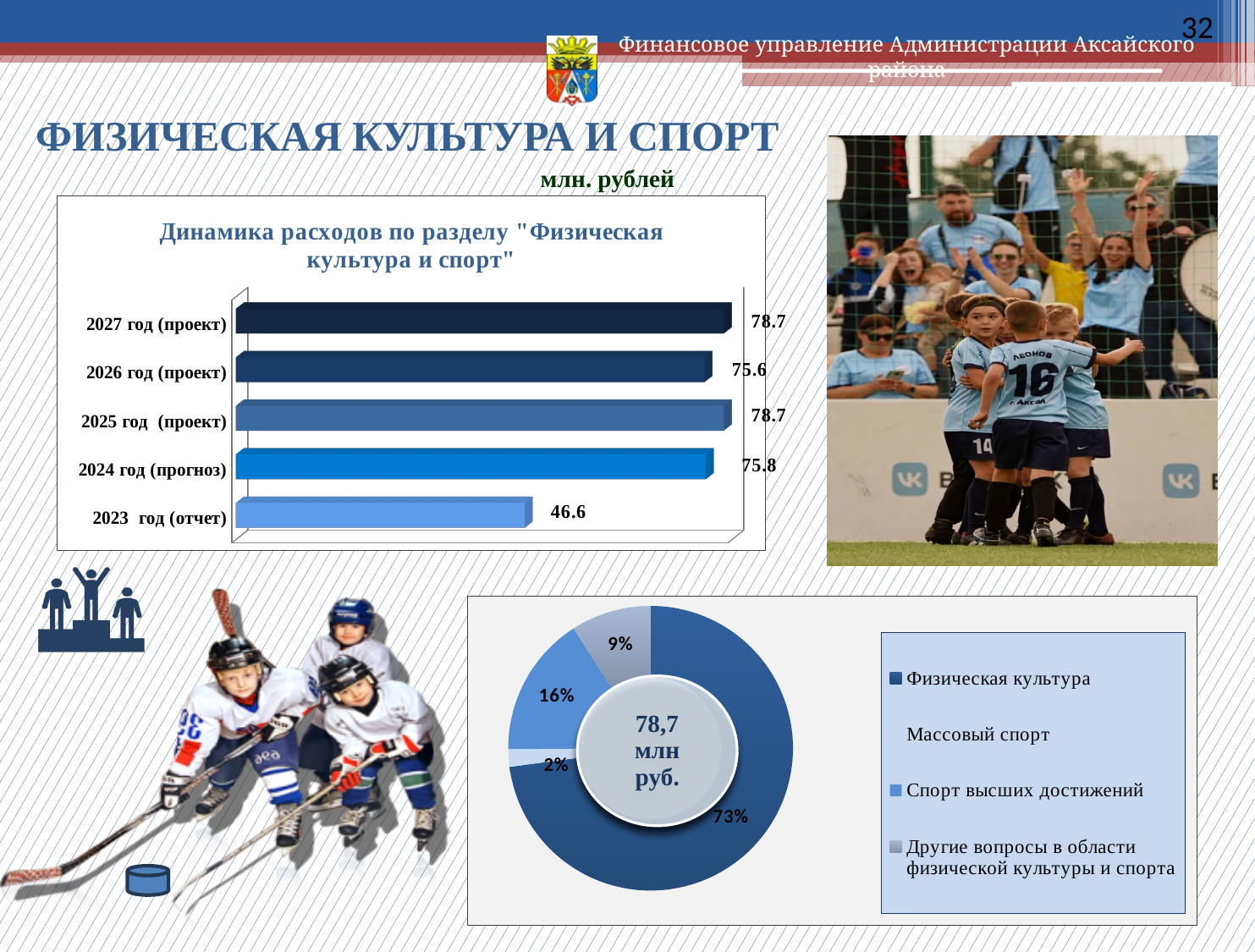
What type of chart is the chart titled "Динамика расходов по разделу "Физическая культура и спорт""? bar chart In the doughnut chart at the bottom of the slide, what share does Спорт высших достижений have? 16% In the bar chart "Динамика расходов по разделу "Физическая культура и спорт"", which is larger: the value for 2024 год (прогноз) or 2026 год (проект)? 2024 год (прогноз) In the doughnut chart at the bottom of the slide, what share does Физическая культура have? 73% How many entries does the legend of the doughnut chart at the bottom of the slide list? 4 In the bar chart "Динамика расходов по разделу "Физическая культура и спорт"", which year has the lowest value? 2023 год (отчет) In the bar chart "Динамика расходов по разделу "Физическая культура и спорт"", what is the value for 2023 год (отчет)? 46.6 How many bars are shown in the bar chart "Динамика расходов по разделу "Физическая культура и спорт""? 5 In the bar chart "Динамика расходов по разделу "Физическая культура и спорт"", what is the value for 2024 год (прогноз)? 75.8 In the bar chart "Динамика расходов по разделу "Физическая культура и спорт"", what is the difference between the values for 2024 год (прогноз) and 2023 год (отчет)? 29.2 In the bar chart "Динамика расходов по разделу "Физическая культура и спорт"", do the values rise or fall from 2023 год (отчет) to 2025 год (проект)? rise In the bar chart "Динамика расходов по разделу "Физическая культура и спорт"", what is the value for 2026 год (проект)? 75.6